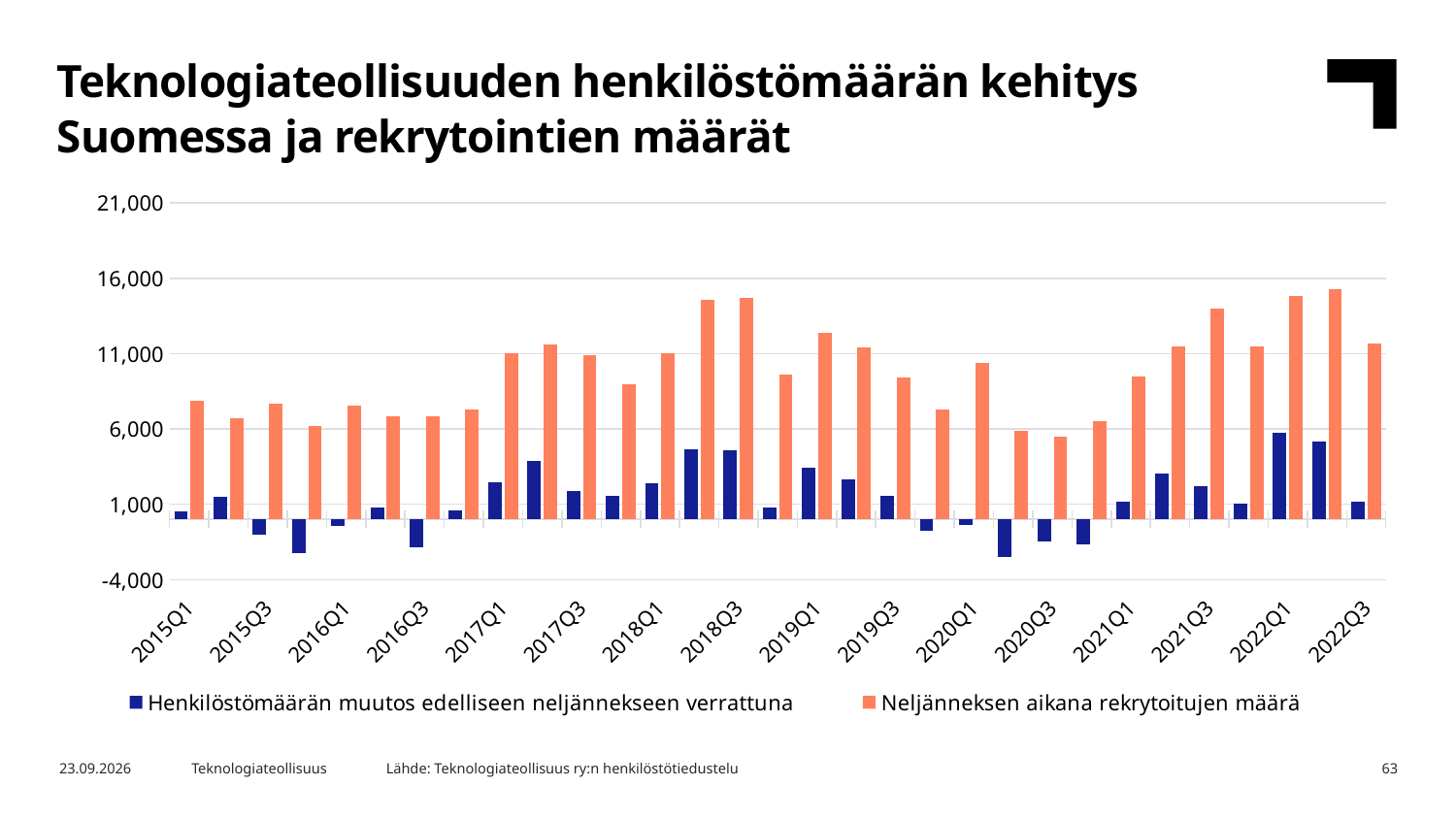
What kind of chart is shown on the slide? Bar chart Is the value of Neljänneksen aikana rekrytoitujen määrä for 2022Q1 greater or less than 11,000? greater Which is larger, the Neljänneksen aikana rekrytoitujen määrä value for 2018Q3 or for 2015Q1? 2018Q3 Is the value of Neljänneksen aikana rekrytoitujen määrä for 2015Q1 greater or less than 6,000? greater Is the value of Neljänneksen aikana rekrytoitujen määrä for 2018Q3 greater or less than 16,000? less How many series does the legend list? 2 What is the name of the series drawn in orange? Neljänneksen aikana rekrytoitujen määrä Which quarter has the highest value for Henkilöstömäärän muutos edelliseen neljännekseen verrattuna? 2022Q1 What is the name of the series drawn in dark blue? Henkilöstömäärän muutos edelliseen neljännekseen verrattuna